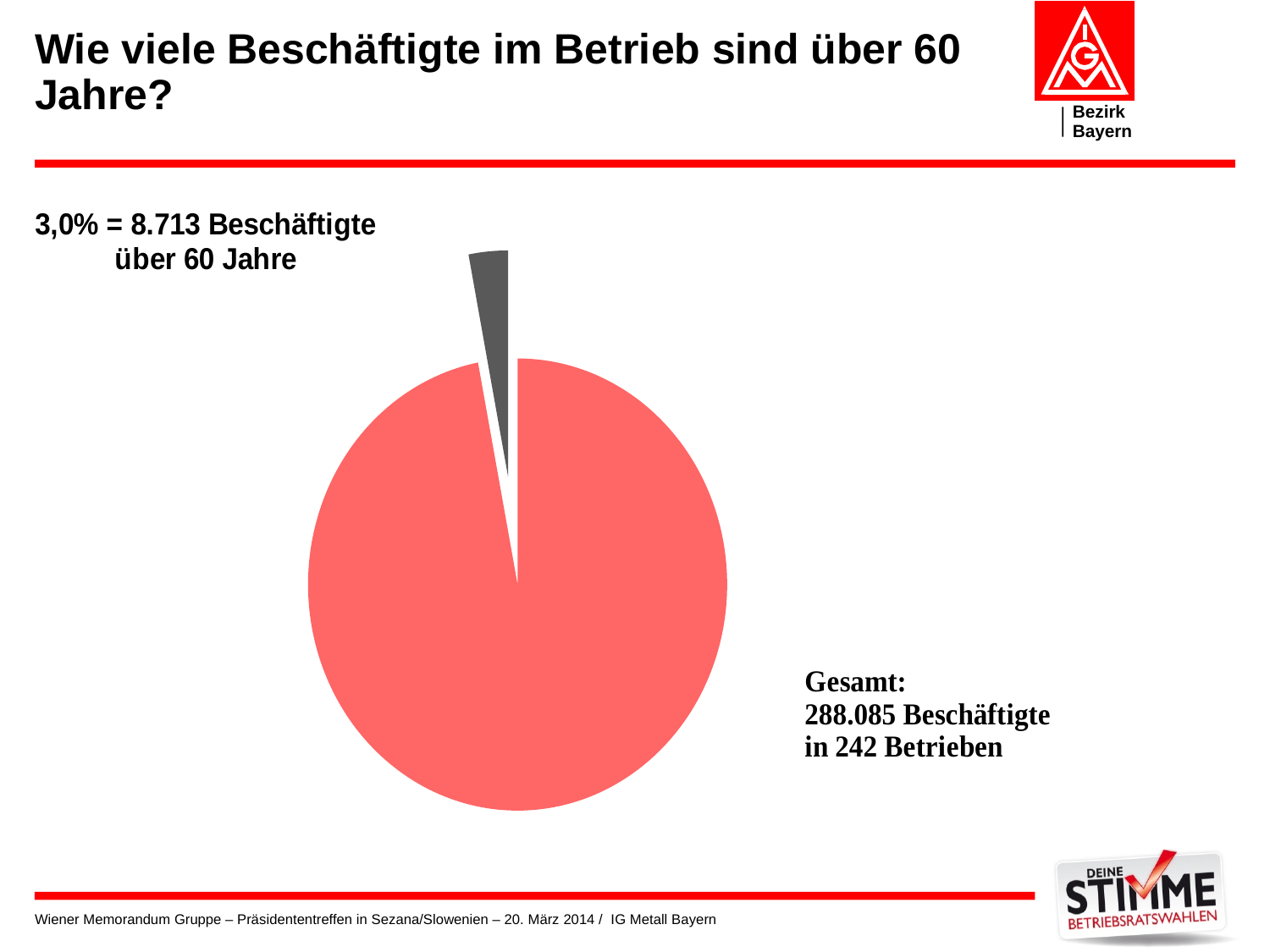
What kind of chart is shown on the slide? pie chart What share of the pie do the employees aged 60 or under (the red slice) represent? 97,0% What is the total number of employees (Gesamt) represented by the whole pie? 288.085 What is the title of the slide containing the pie chart? Wie viele Beschäftigte im Betrieb sind über 60 Jahre? How many employees over 60 years does the small slice of the pie represent? 8.713 What colour is the slice representing employees over 60 years? grey What share of the pie does the small grey slice (employees over 60) represent? 3,0% How many slices does the pie chart have? 2 Which slice of the pie is larger, the red slice or the grey slice? the red slice How many employees are not over 60, i.e. the total minus the 8.713 over 60? 279.372 In how many companies (Betriebe) are the 288.085 employees counted? 242